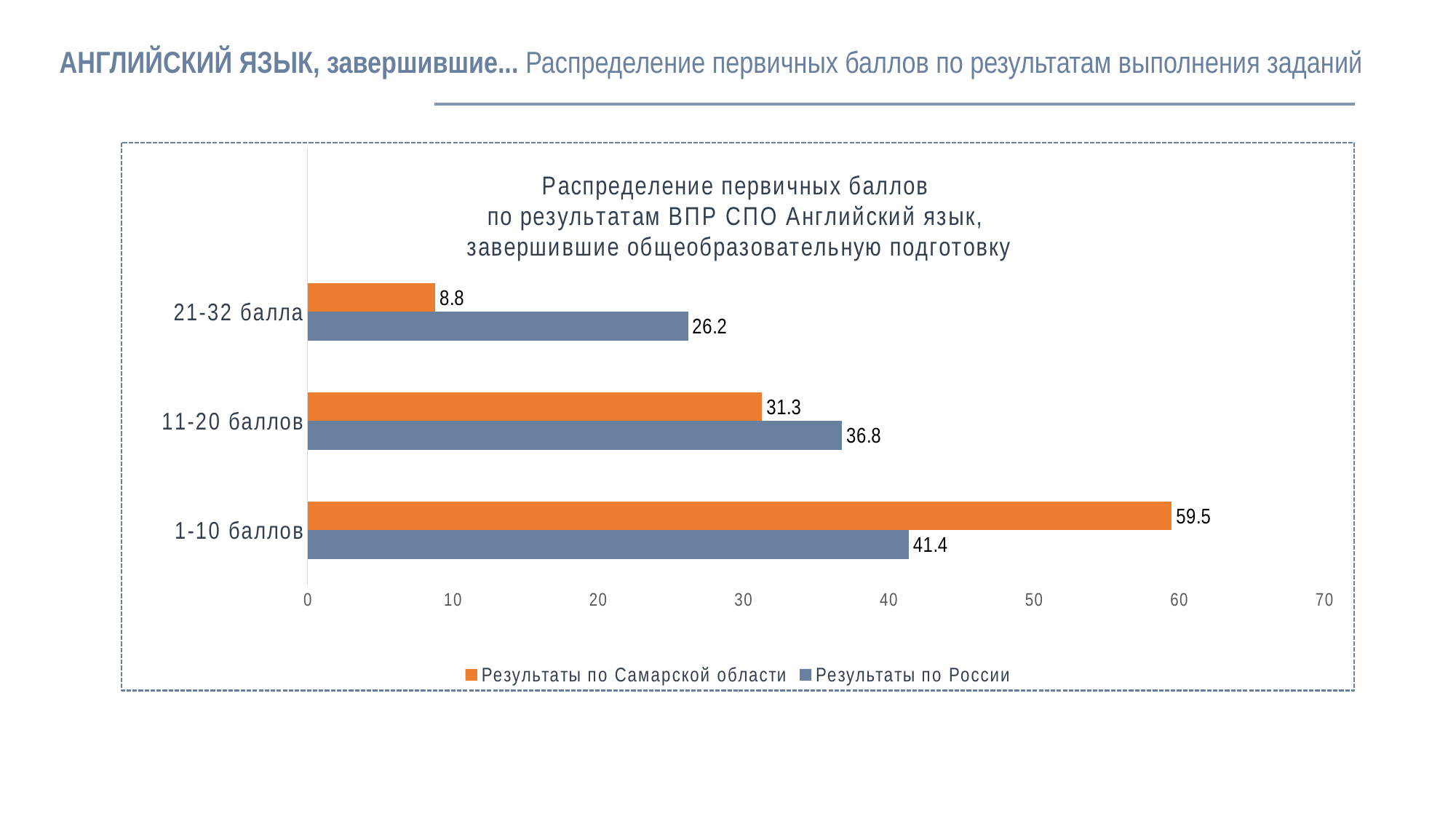
Which category has the lowest value for Результаты по Самарской области? 21-32 балла What is the value for Результаты по России in the 21-32 балла category? 26.2 Which category has the highest value for Результаты по России? 1-10 баллов What kind of chart is shown on the slide? bar chart What is the difference between Результаты по Самарской области and Результаты по России in the 1-10 баллов category? 18.1 In the 11-20 баллов category, which series has the larger value? Результаты по России What is the value for Результаты по Самарской области in the 11-20 баллов category? 31.3 Which colour represents Результаты по Самарской области in the chart? orange How many series does the legend list? 2 How many score categories are shown on the chart? 3 What is the difference between Результаты по России and Результаты по Самарской области in the 21-32 балла category? 17.4 What is the value for Результаты по Самарской области in the 1-10 баллов category? 59.5